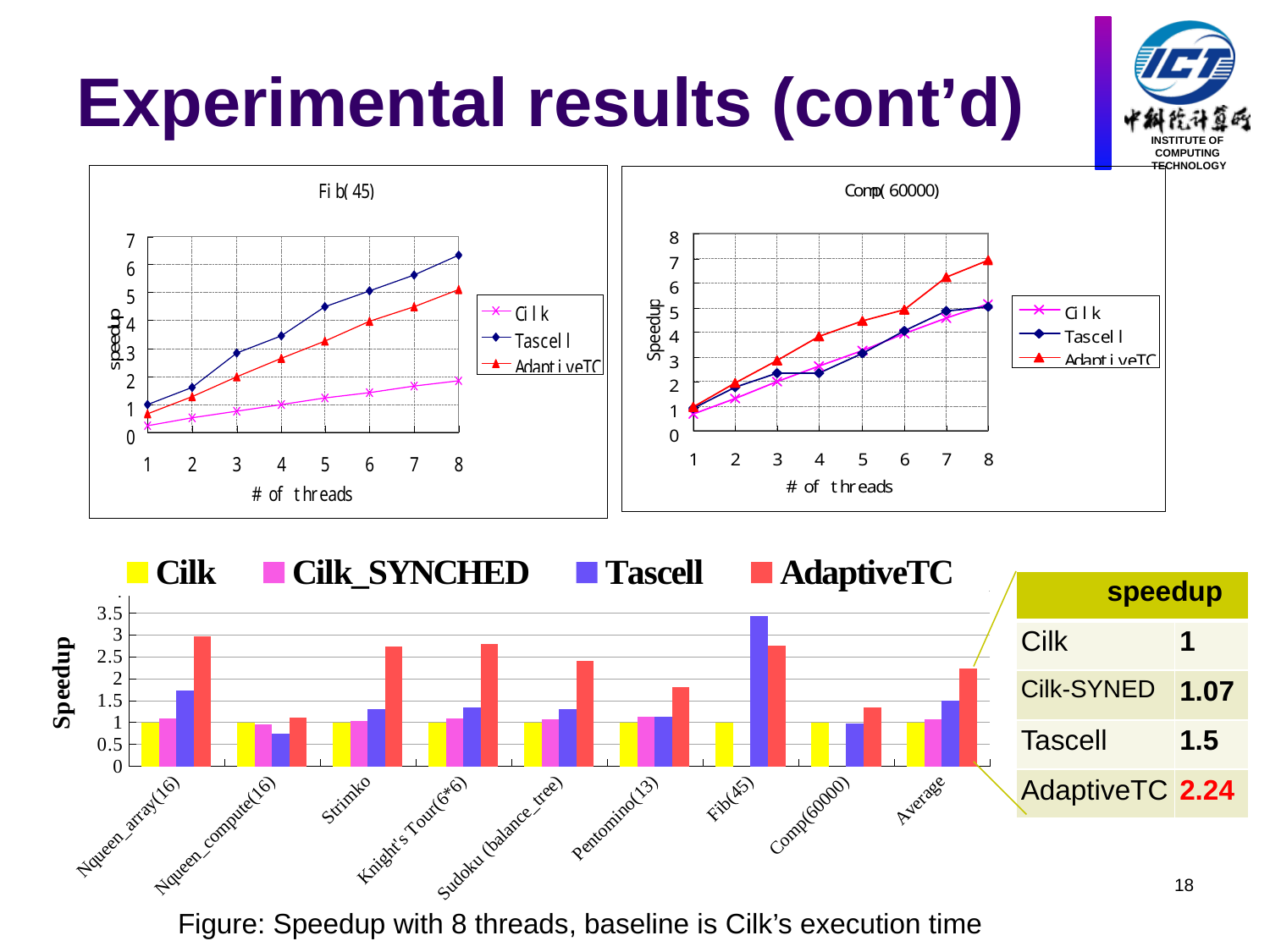
According to the speedup table next to the bottom chart, what is the difference between the Average speedup of AdaptiveTC and Tascell? 0.74 In the Fib(45) chart, is the Tascell speedup at 8 threads greater or less than 6? greater In the Comp(60000) chart, is the AdaptiveTC speedup at 8 threads greater or less than 6? greater How many benchmark categories are shown on the x axis of the bottom speedup bar chart? 9 In the Fib(45) chart, which series has the highest speedup at 8 threads? Tascell In the bottom speedup bar chart, which is larger for Fib(45): the Tascell bar or the AdaptiveTC bar? Tascell In the Comp(60000) chart, which series has the highest speedup at 8 threads? AdaptiveTC How many series does the legend of the Comp(60000) chart list? 3 How many series does the legend of the bottom speedup bar chart list? 4 What kind of chart is the bottom chart showing speedup with 8 threads? bar chart What kind of chart is the Fib(45) chart at the top left of the slide? line chart According to the speedup table next to the bottom chart, what is the Average speedup of AdaptiveTC? 2.24